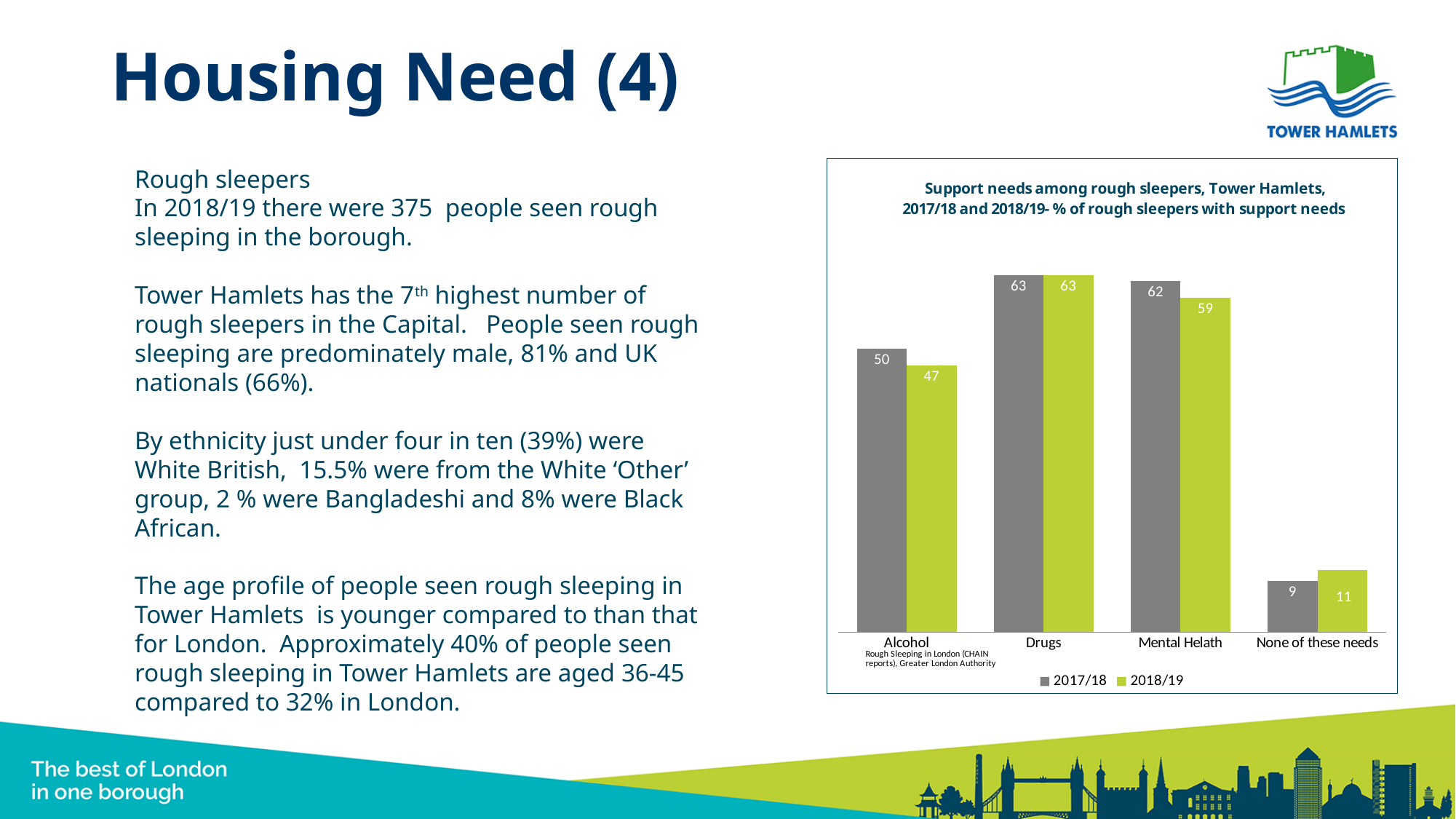
What is the value for None of these needs in 2018/19? 11 Did the value for Drugs rise, fall or stay the same from 2017/18 to 2018/19? Stayed the same Which category has the lowest value in 2017/18? None of these needs What kind of chart is shown on the slide? Bar chart What is the difference between the 2017/18 and 2018/19 values for Alcohol? 3 What is the value for Alcohol in 2017/18? 50 Which is larger for Mental Helath: the 2017/18 value or the 2018/19 value? 2017/18 Which colour represents the 2018/19 series in the chart? Green How many categories are shown on the x axis? 4 What is the value for Mental Helath in 2018/19? 59 How many series does the legend list? 2 Which category has the highest value in 2018/19? Drugs